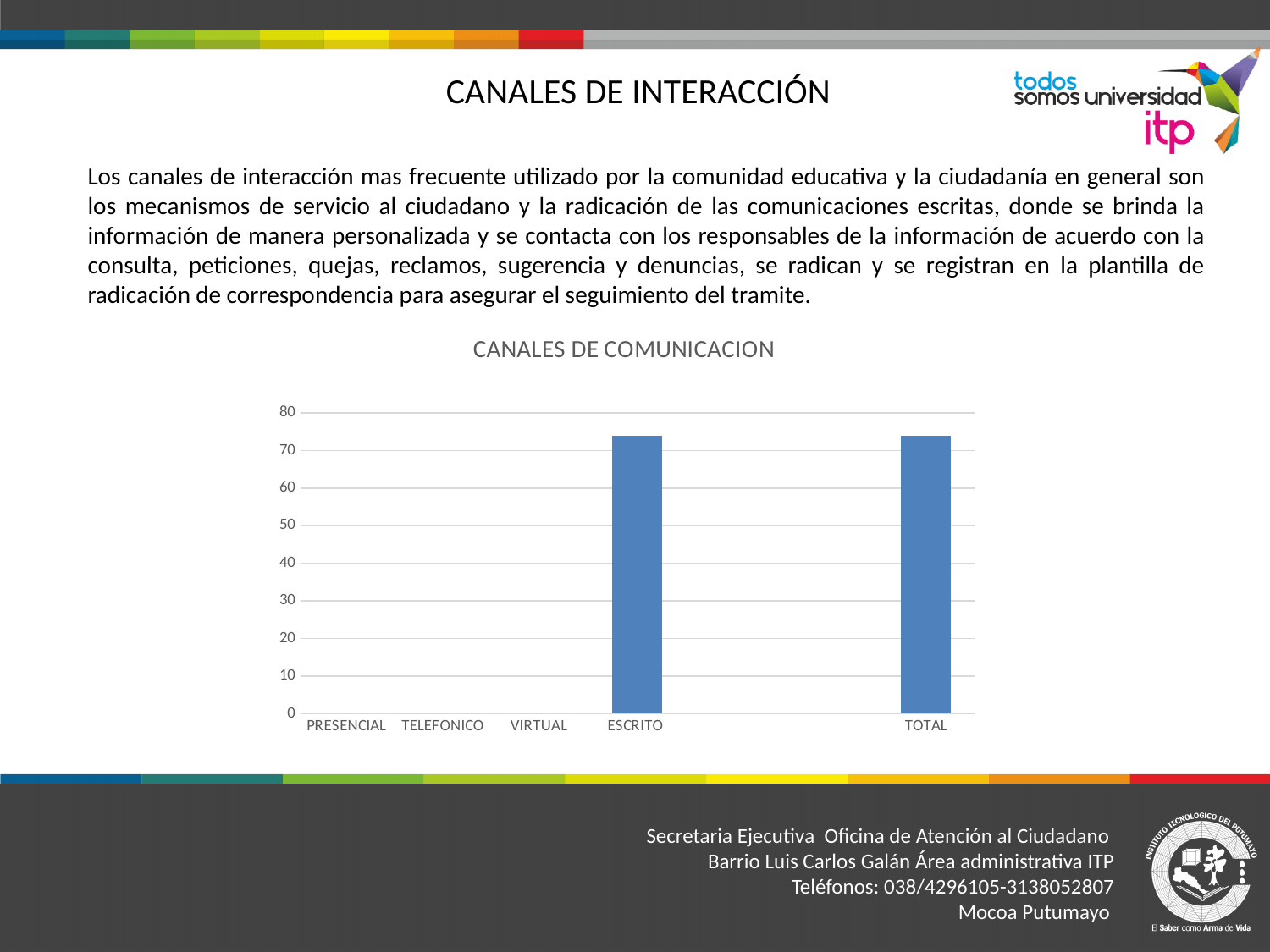
How many visible bars does the chart have? 2 What is the highest value shown on the y axis? 80 Is the value for ESCRITO greater or less than 80? less Is the value for ESCRITO greater or less than 70? greater Which is larger, the value for TOTAL or the value for PRESENCIAL? TOTAL Is the value for ESCRITO greater or less than 50? greater What kind of chart is shown on the slide? bar chart What is the title of the chart? CANALES DE COMUNICACION Which is larger, the value for ESCRITO or the value for VIRTUAL? ESCRITO Which categories on the x axis have a visible bar? ESCRITO and TOTAL